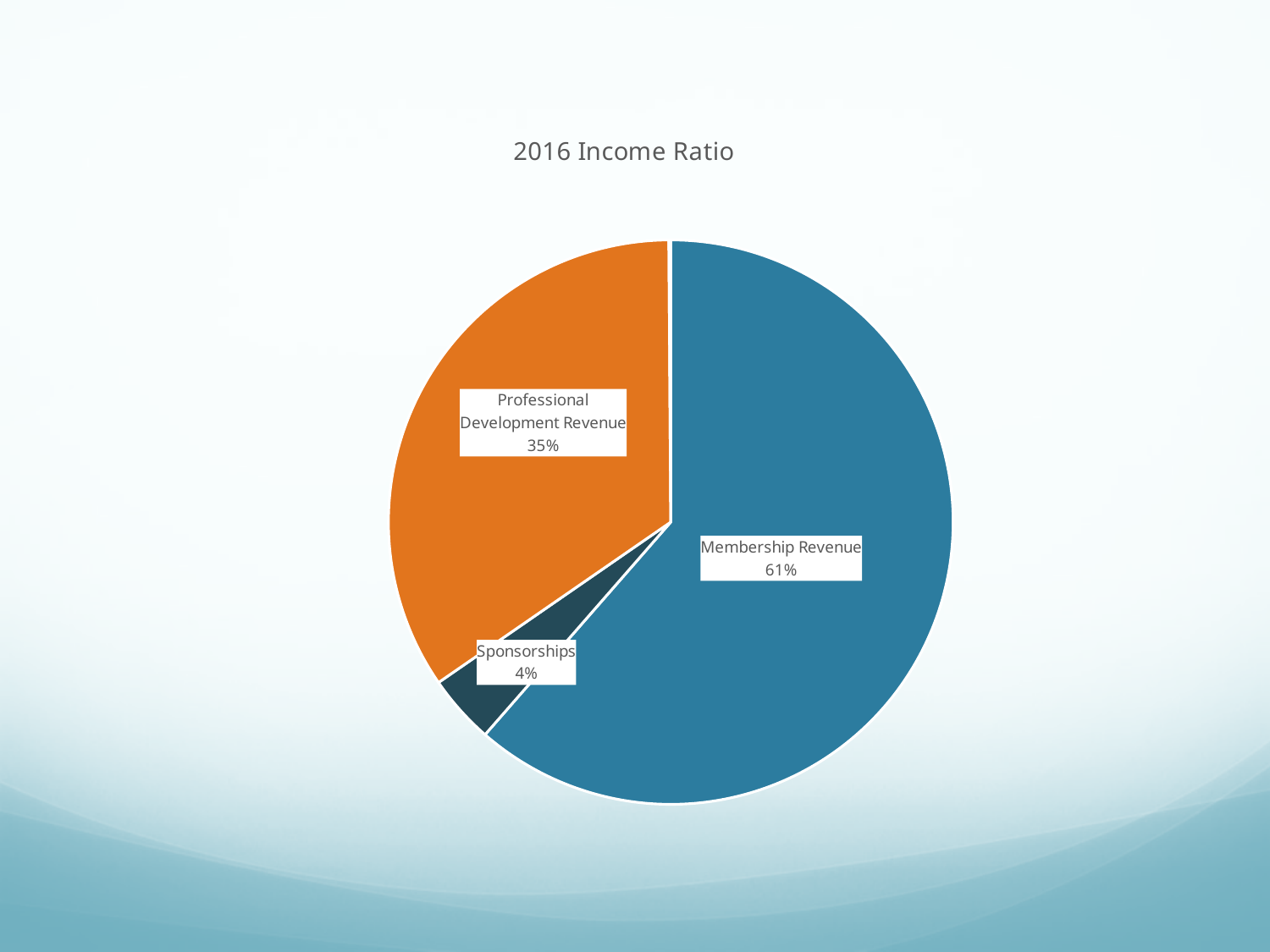
What is the difference in percentage points between Membership Revenue and Professional Development Revenue? 26 Which category has the largest slice of the pie? Membership Revenue What is the title of the chart? 2016 Income Ratio How many categories are shown in the pie chart? 3 Which category has the smallest slice of the pie? Sponsorships What colour is the Professional Development Revenue slice? Orange Which is larger, Professional Development Revenue or Sponsorships? Professional Development Revenue What share of the pie does Professional Development Revenue represent? 35% What share of the pie does Membership Revenue represent? 61% What share of the pie does Sponsorships represent? 4% What is the difference in percentage points between Professional Development Revenue and Sponsorships? 31 What kind of chart is shown on the slide? Pie chart